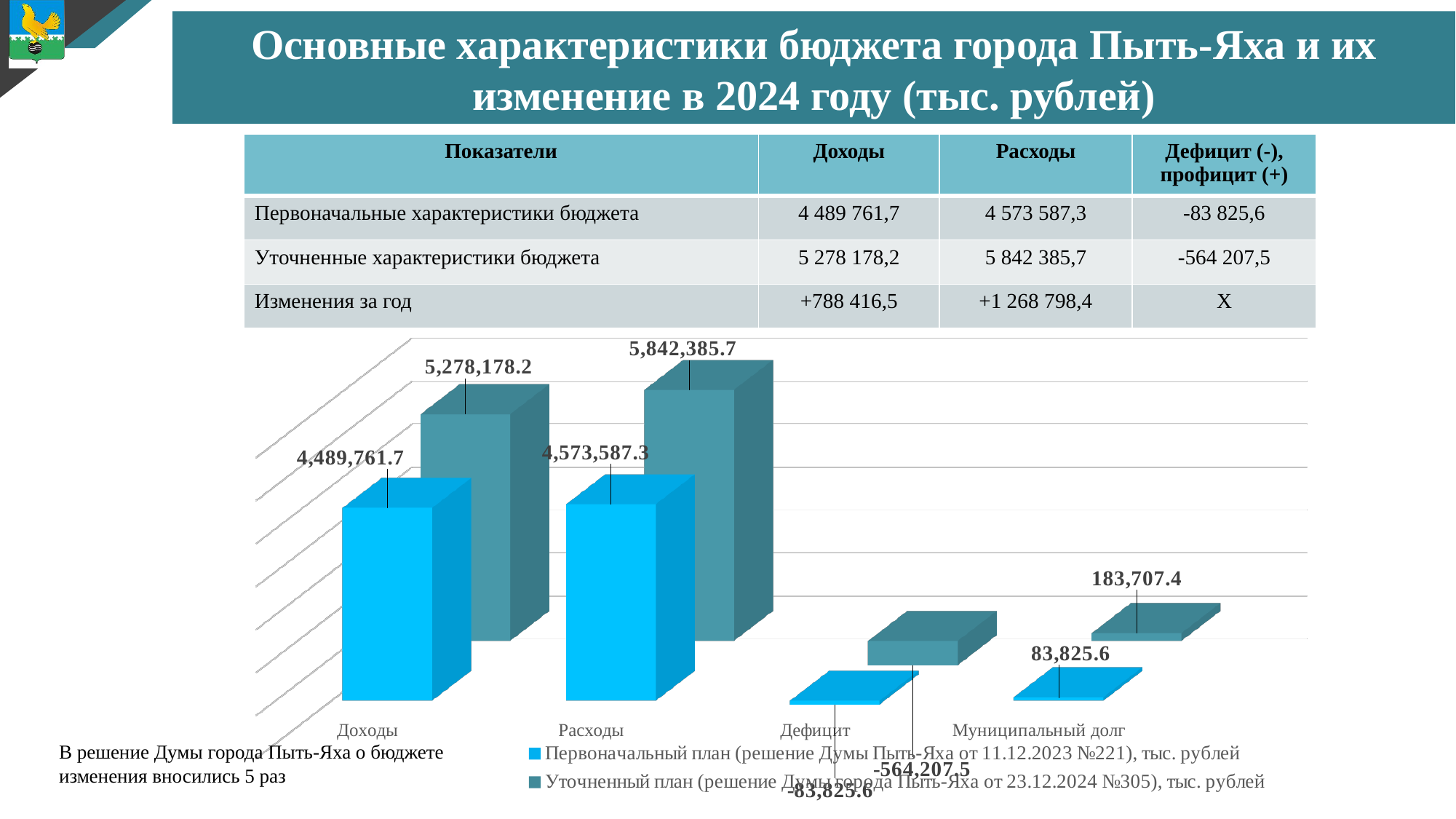
How many categories are shown on the x axis of the chart? 4 Which is larger: the Первоначальный план value for Доходы or the Первоначальный план value for Расходы? Расходы What is the value for Муниципальный долг in the Уточненный план series? 183,707.4 What type of chart is shown on the slide? Bar chart What is the value for Дефицит in the Уточненный план series? -564,207.5 What is the value for Расходы in the Уточненный план series? 5,842,385.7 Which category has the lowest value in the Первоначальный план series? Дефицит What is the difference between the Уточненный план and Первоначальный план values for Расходы? 1,268,798.4 Which category has the highest value in the Уточненный план series? Расходы What is the difference between the Уточненный план and Первоначальный план values for Доходы? 788,416.5 What is the value for Доходы in the Первоначальный план series? 4,489,761.7 How many series does the chart legend list? 2